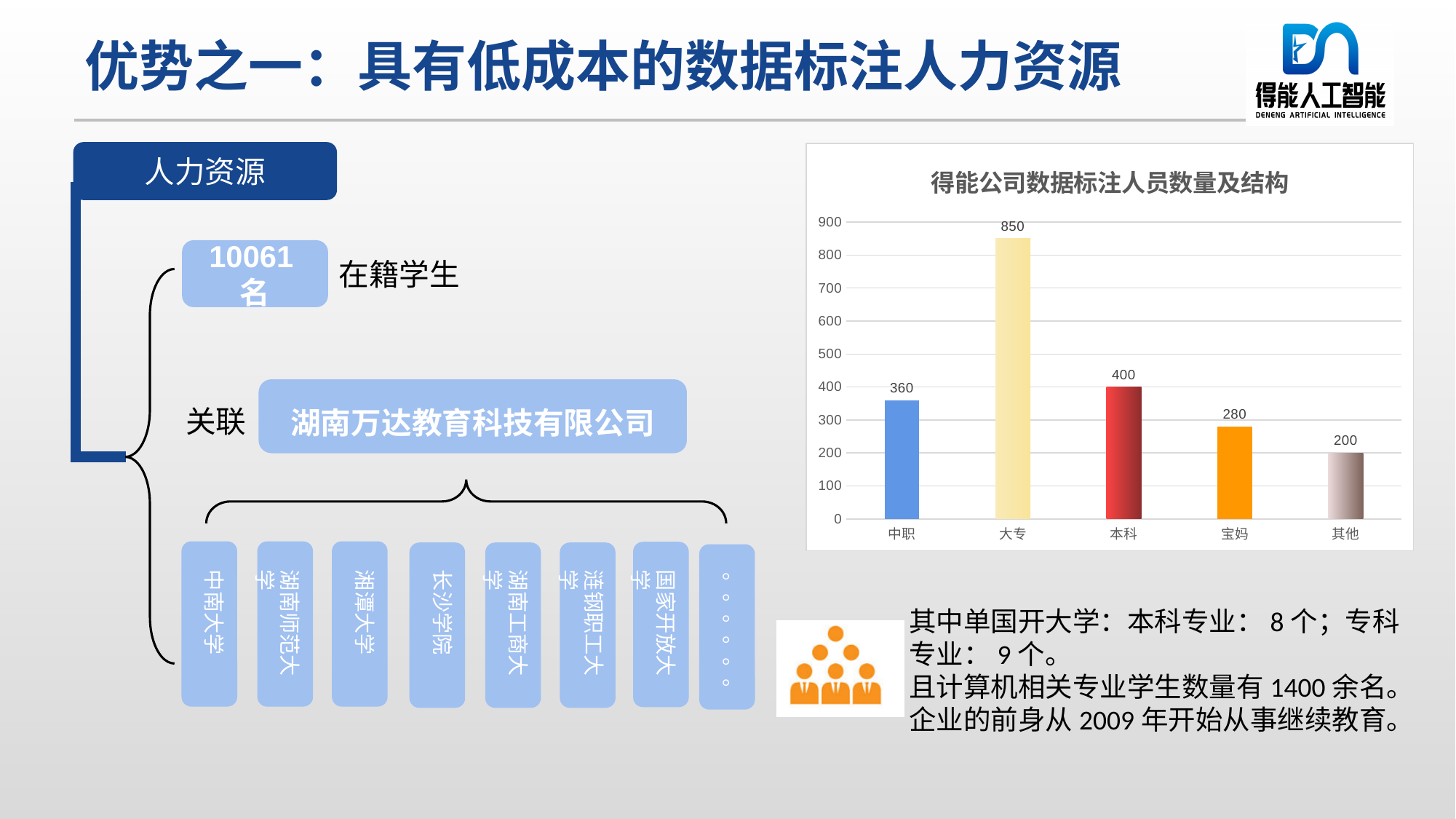
Which category has the highest value in the chart? 大专 What is the value for 中职 in the chart? 360 What is the value for 大专 in the chart? 850 Which category has the lowest value in the chart? 其他 What is the difference between the values for 中职 and 其他? 160 Which is larger, the value for 本科 or the value for 中职? 本科 What is the difference between the values for 大专 and 本科? 450 Is the value for 宝妈 greater or less than 300? less How many categories are shown in the chart? 5 What is the title of the chart? 得能公司数据标注人员数量及结构 What is the value for 宝妈 in the chart? 280 What kind of chart is shown on the slide? bar chart